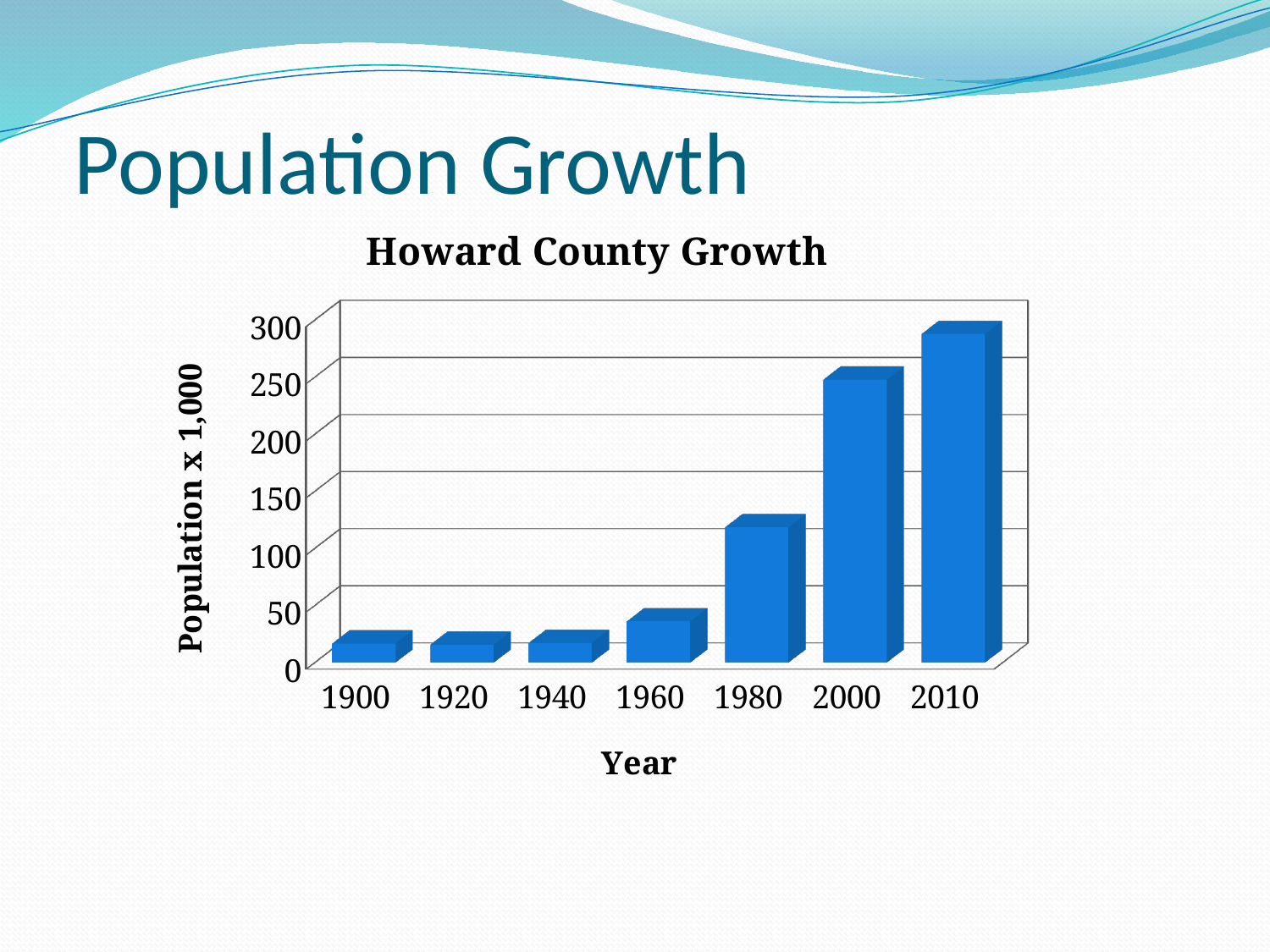
Is the value for 1980 greater or less than 150? less How many years are shown on the x axis of the chart? 7 What kind of chart is shown on the slide? bar chart Which is larger, the value for 1960 or the value for 1980? 1980 Is the value for 2000 greater or less than 200? greater What is the title of the chart? Howard County Growth Which year has the highest population in the chart? 2010 Is the value for 2010 greater or less than 250? greater Which is larger, the value for 1980 or the value for 2000? 2000 What is the label of the vertical axis? Population x 1,000 Do the values generally rise or fall from 1900 to 2010? rise